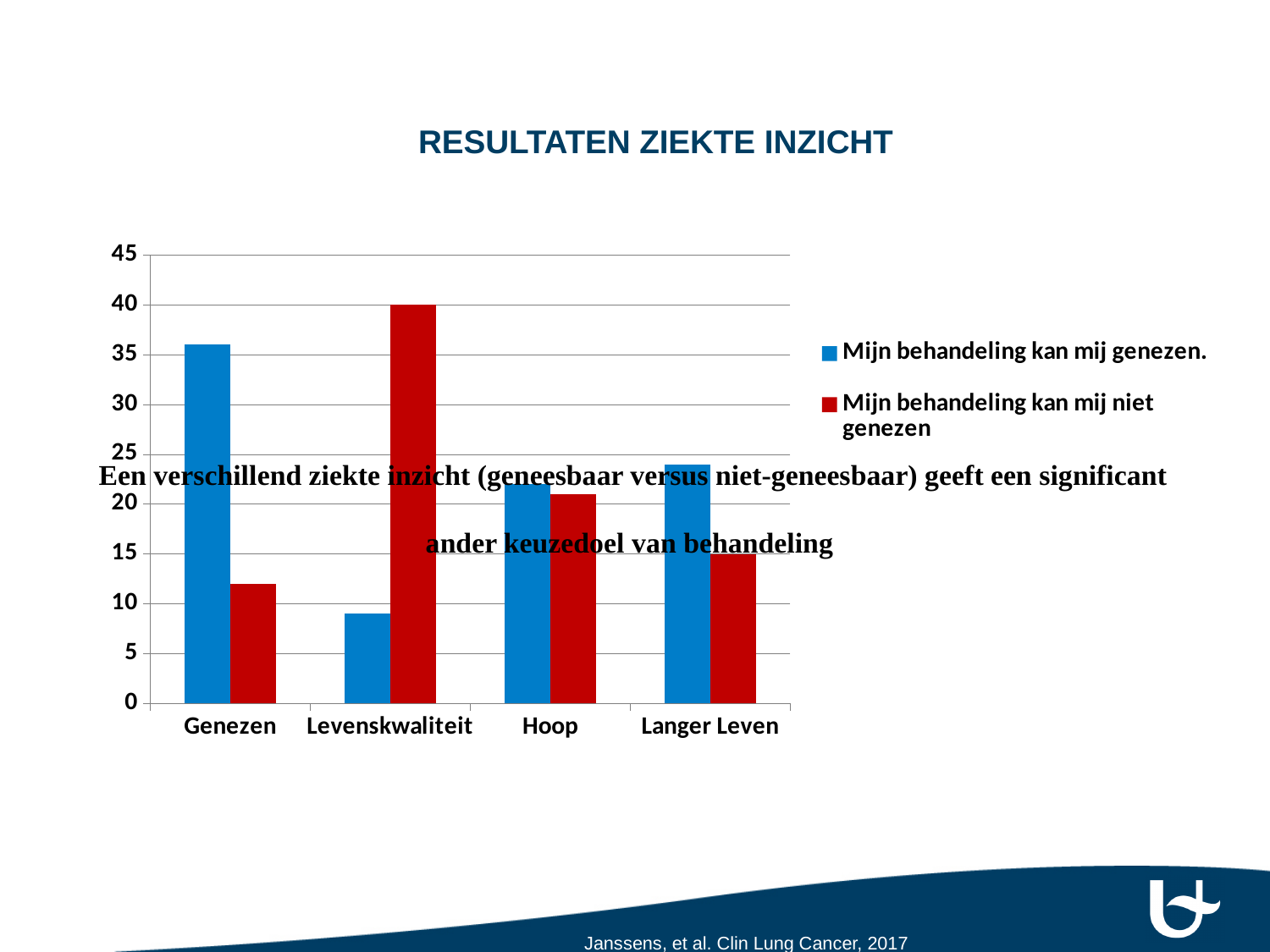
What is the title of the slide above the chart? RESULTATEN ZIEKTE INZICHT How many categories are shown on the x axis of the chart? 4 Is the value for Genezen in the series "Mijn behandeling kan mij genezen." greater or less than 30? greater Is the value for Genezen in the series "Mijn behandeling kan mij niet genezen" greater or less than 15? less For Genezen, which series has the larger value? Mijn behandeling kan mij genezen. Which category has the highest value in the series "Mijn behandeling kan mij niet genezen"? Levenskwaliteit Is the value for Langer Leven in the series "Mijn behandeling kan mij genezen." greater or less than 20? greater Which category has the lowest value in the series "Mijn behandeling kan mij genezen."? Levenskwaliteit How many series does the legend list? 2 For Levenskwaliteit, which series has the larger value? Mijn behandeling kan mij niet genezen What kind of chart is shown on the slide? bar chart